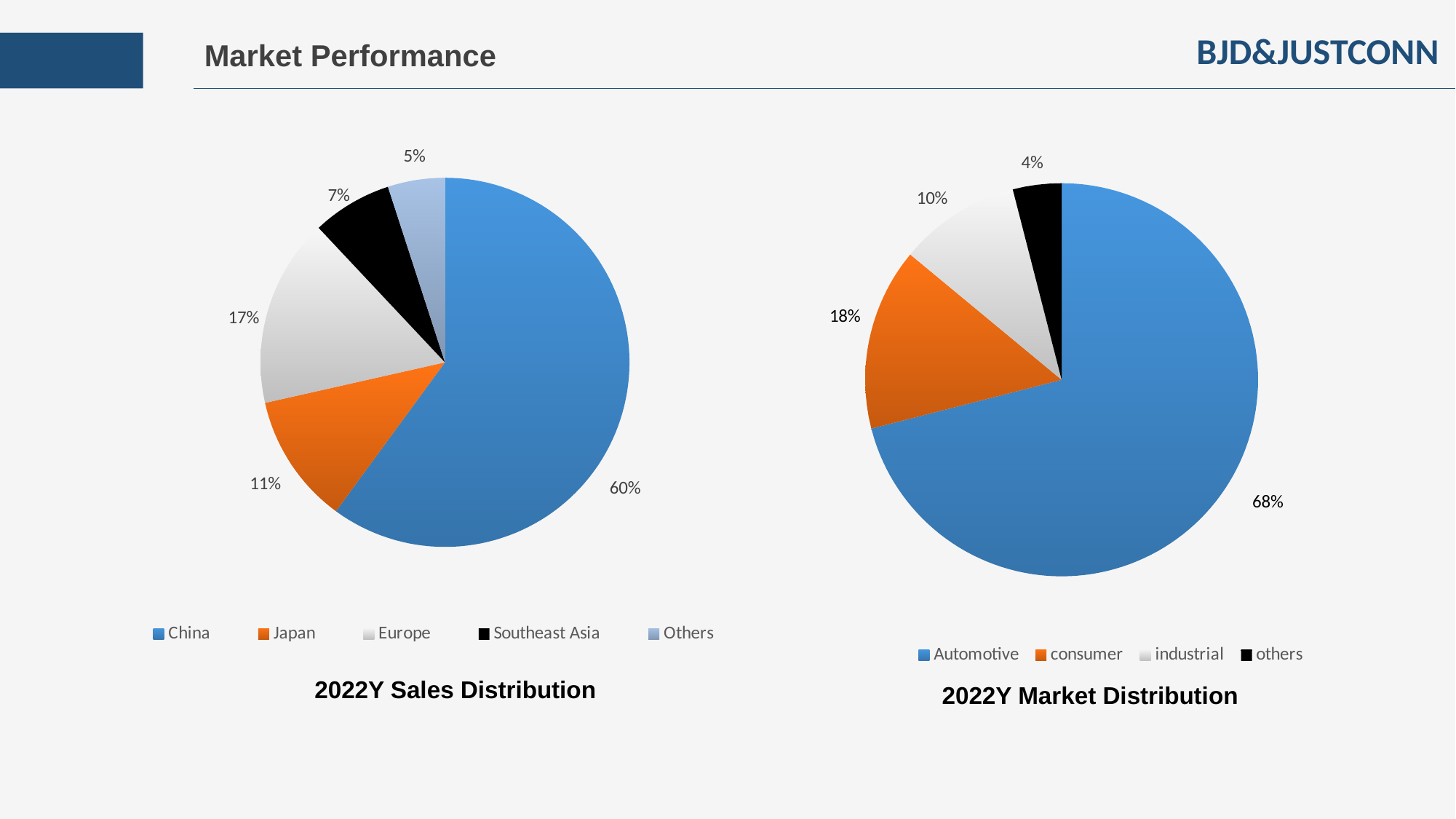
In the 2022Y Sales Distribution chart, what share does China have? 60% In the 2022Y Sales Distribution chart, how many regions are shown? 5 In the 2022Y Sales Distribution chart, which region has the smallest share? Others In the 2022Y Market Distribution chart, what is the difference between the shares of consumer and industrial? 8% In the 2022Y Market Distribution chart, what share does Automotive have? 68% In the 2022Y Sales Distribution chart, what is the difference between the shares of Europe and Japan? 6% In the 2022Y Market Distribution chart, how many segments are shown? 4 In the 2022Y Market Distribution chart, which segment has the smallest share? others In the 2022Y Sales Distribution chart, which has the larger share, Japan or Southeast Asia? Japan What type of chart is the 2022Y Market Distribution chart? Pie chart In the 2022Y Market Distribution chart, what share does consumer have? 18% In the 2022Y Sales Distribution chart, what share does Europe have? 17%